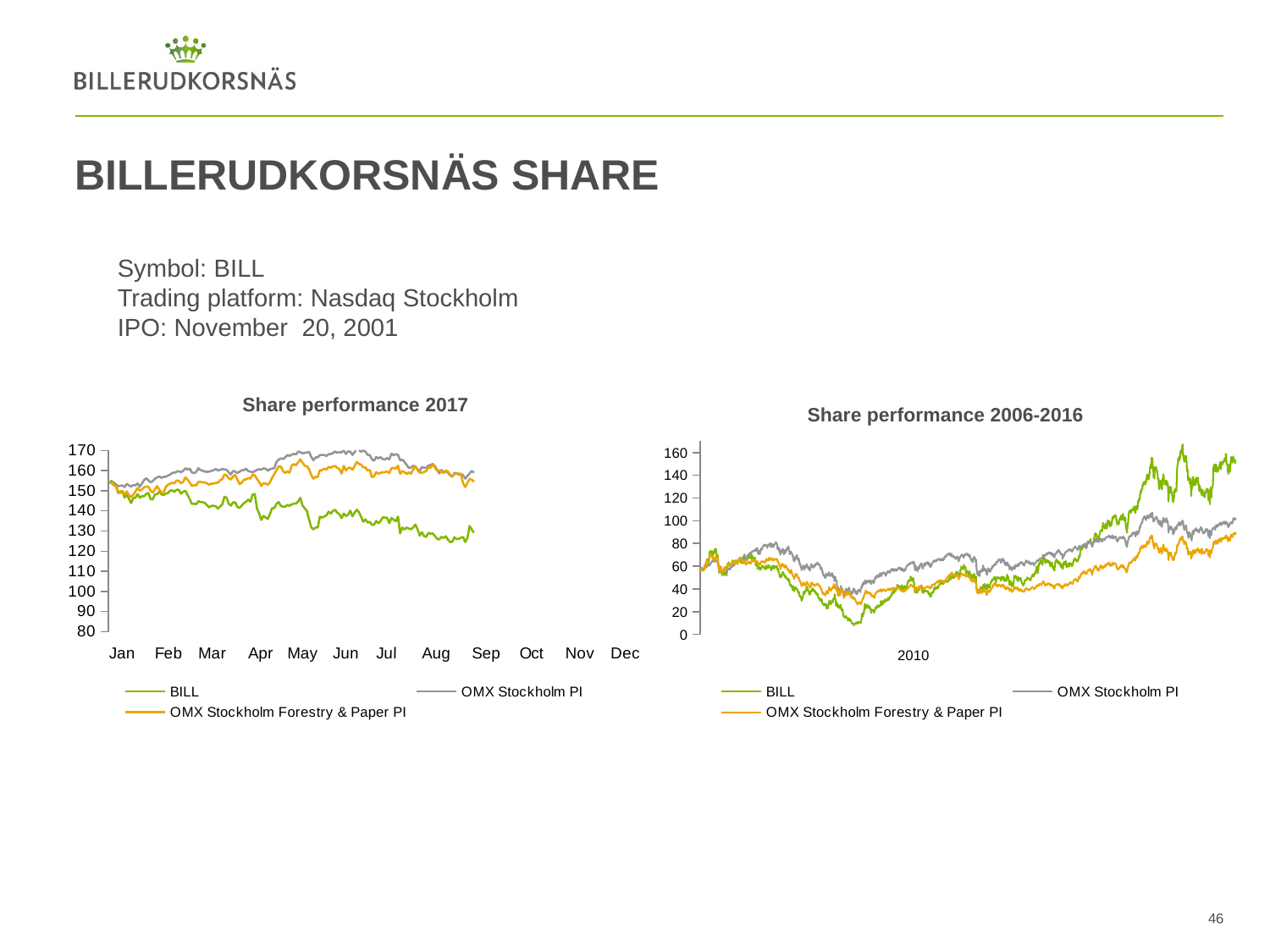
In the 'Share performance 2017' chart, is the value of BILL at the end of August greater or less than 140? less Which series is drawn in orange in both charts? OMX Stockholm Forestry & Paper PI In the 'Share performance 2017' chart, which series is higher in August: BILL or OMX Stockholm PI? OMX Stockholm PI How many series does the legend of the 'Share performance 2017' chart list? 3 In the 'Share performance 2006-2016' chart, which series is higher at the end of the period: OMX Stockholm PI or OMX Stockholm Forestry & Paper PI? OMX Stockholm PI In the 'Share performance 2017' chart, does the BILL line rise or fall from January to September? fall What kind of chart is the 'Share performance 2017' chart? line chart In the 'Share performance 2006-2016' chart, is the lowest point of the BILL line greater or less than 20? less In the 'Share performance 2017' chart, is the value of OMX Stockholm PI in June greater or less than 160? greater In the 'Share performance 2017' chart, which series is lowest at the end of the plotted period? BILL In the 'Share performance 2006-2016' chart, which series is highest at the end of the period? BILL What kind of chart is the 'Share performance 2006-2016' chart? line chart